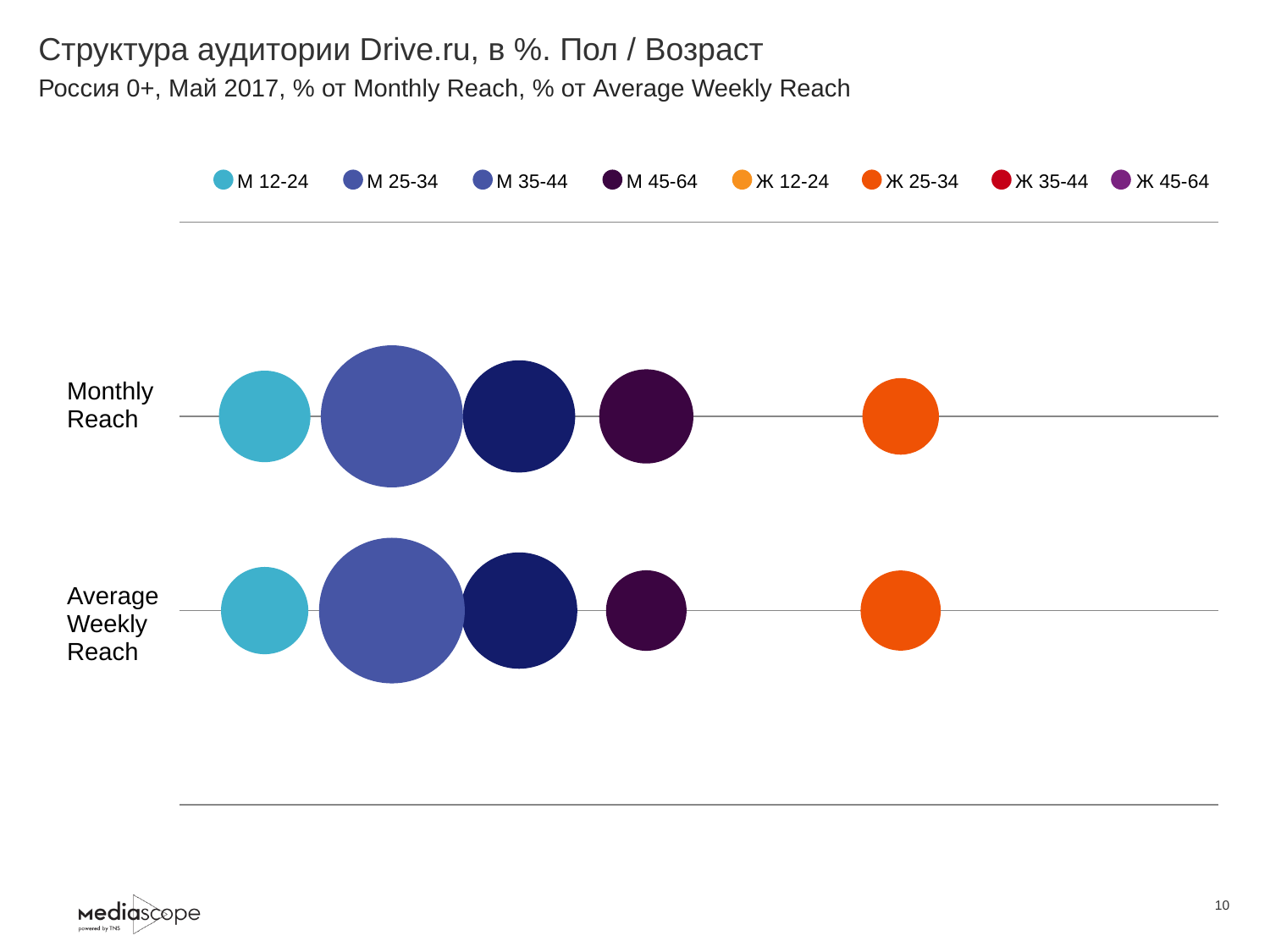
What is the title of the chart on the slide? Структура аудитории Drive.ru, в %. Пол / Возраст In the Monthly Reach row, which bubble is larger: М 25-34 or Ж 25-34? М 25-34 How many series does the legend list? 8 How many rows (categories) are plotted on the chart? 2 Which legend entry is shown in orange? Ж 25-34 What are the two row labels on the chart? Monthly Reach and Average Weekly Reach What kind of chart is shown on the slide? Bubble chart In the Monthly Reach row, which bubble is larger: М 25-34 or М 12-24? М 25-34 Which series has the largest bubble in the Monthly Reach row? М 25-34 In the Average Weekly Reach row, which bubble is larger: М 35-44 or М 45-64? М 35-44 Which series has the largest bubble in the Average Weekly Reach row? М 25-34